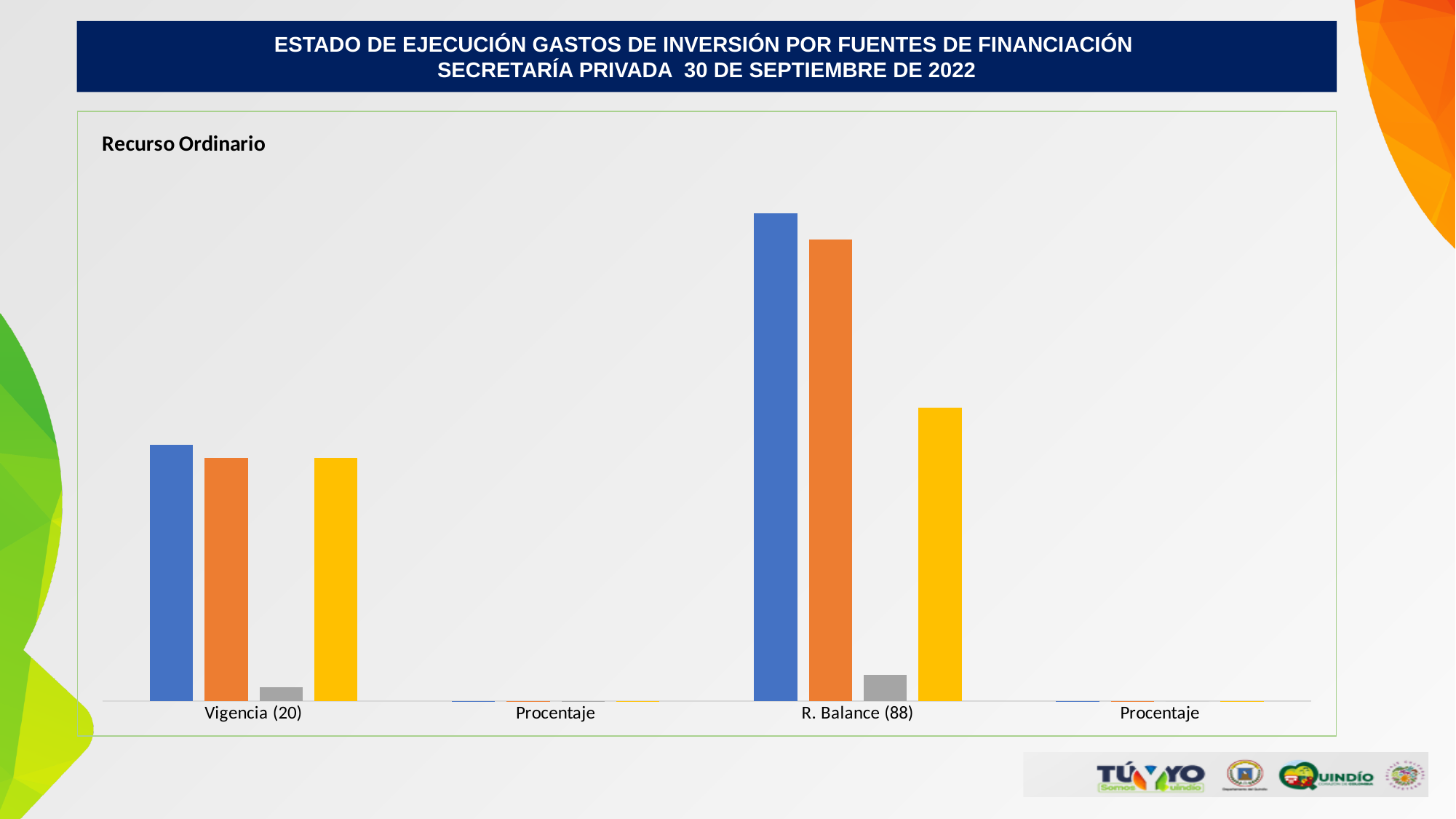
What kind of chart is shown on the slide? Bar chart Is the blue bar larger for Vigencia (20) or for R. Balance (88)? R. Balance (88) Within the R. Balance (88) group, is the blue bar or the yellow bar taller? Blue What is the title of the chart? Recurso Ordinario Within the Vigencia (20) group, which coloured bar is the tallest? Blue How many categories are shown on the x axis of the chart? 4 How many differently coloured bars appear in the Vigencia (20) group? 4 Is the orange bar larger for Vigencia (20) or for R. Balance (88)? R. Balance (88) Which category has the tallest bar in the chart? R. Balance (88) Within the R. Balance (88) group, which coloured bar is the shortest? Grey